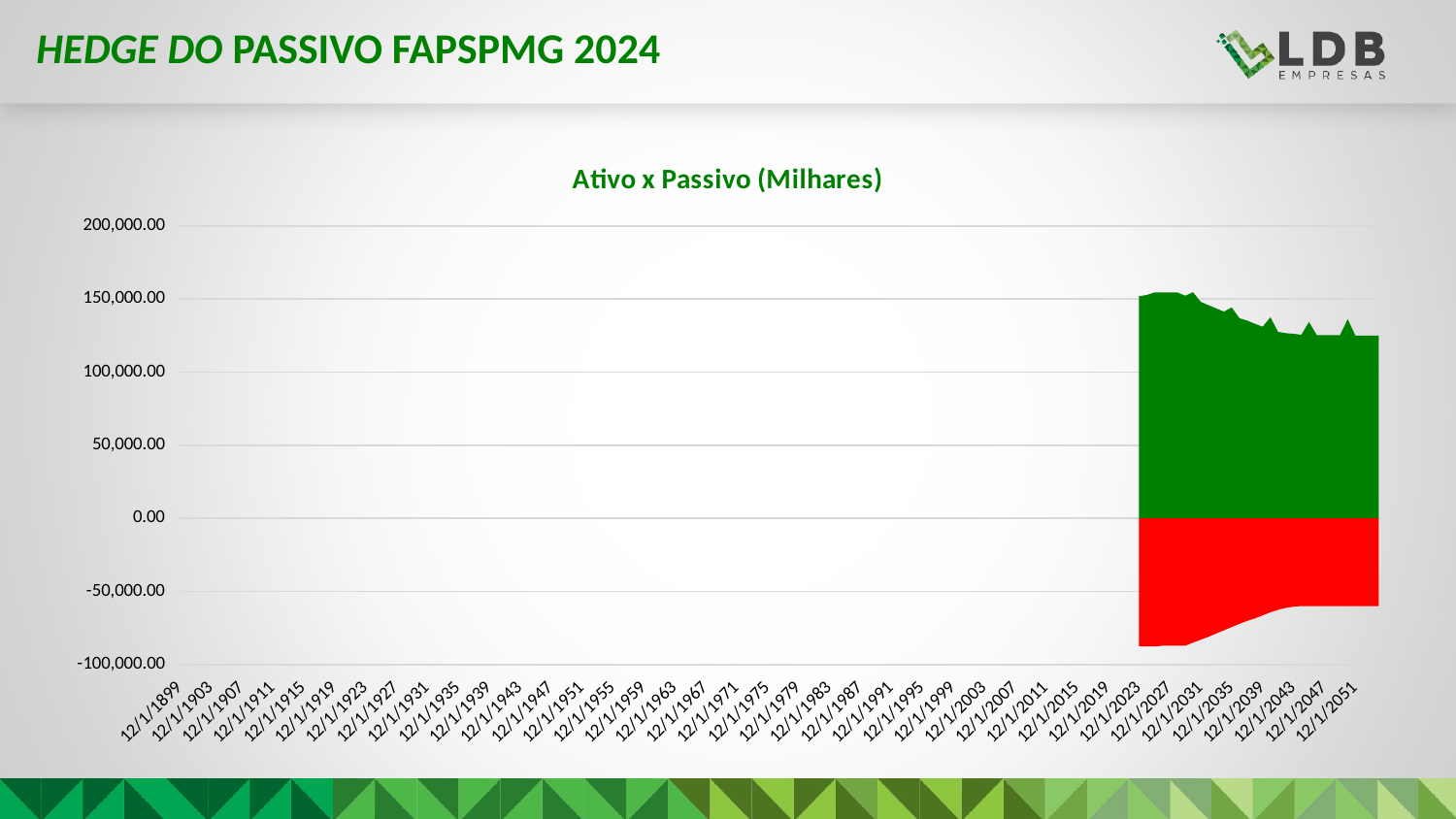
What is the lowest value shown on the vertical axis? -100,000.00 What is the title of the chart? Ativo x Passivo (Milhares) Is the value of the green area at 12/1/2051 greater or less than 100,000.00? greater Is the value of the green area at 12/1/2051 greater or less than 150,000.00? less Does the green area rise or fall from 12/1/2027 to 12/1/2051? fall Is the value of the green area at 12/1/2027 greater or less than 100,000.00? greater Does the red area rise or fall from 12/1/2027 to 12/1/2051? rise What kind of chart is shown on the slide? Area chart What is the highest value shown on the vertical axis? 200,000.00 How many tick labels are shown on the vertical axis? 7